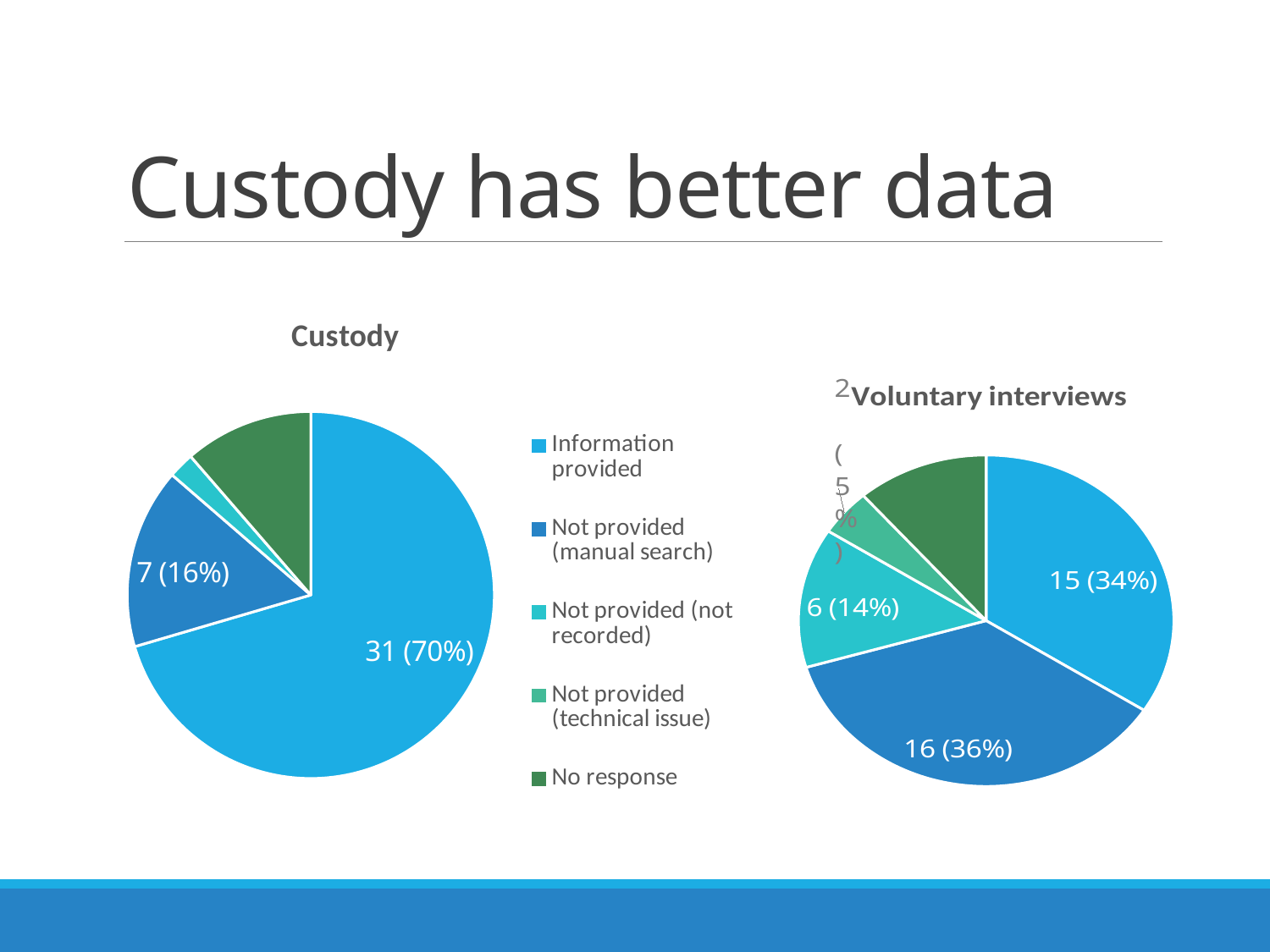
What kind of chart is the Custody chart? pie chart Which chart has the larger count for Information provided, Custody or Voluntary interviews? Custody In the Custody chart, what is the value shown for Information provided? 31 (70%) How many categories does the legend list? 5 In the Voluntary interviews chart, what is the value shown for Information provided? 15 (34%) In the Custody chart, what share of the pie is Information provided? 70% In the Custody chart, which category has the largest slice? Information provided In the Custody chart, what is the value shown for Not provided (manual search)? 7 (16%) In the Voluntary interviews chart, what is the value shown for Not provided (manual search)? 16 (36%) In the Voluntary interviews chart, what is the value shown for Not provided (not recorded)? 6 (14%) In the Custody chart, what is the difference between the counts for Information provided and Not provided (manual search)? 24 In the Voluntary interviews chart, which category has the largest slice? Not provided (manual search)